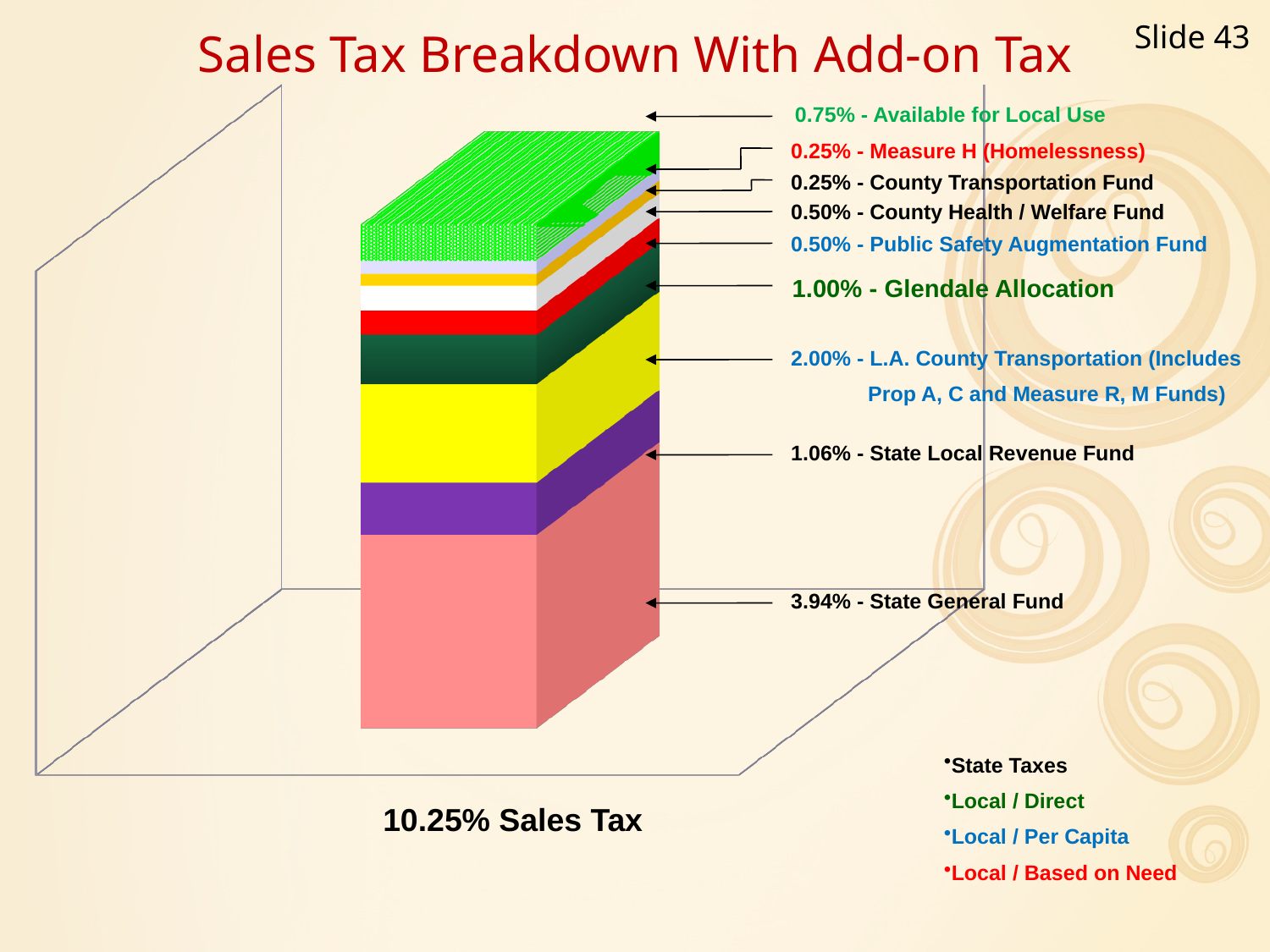
Which segment of the stacked bar has the largest share? State General Fund What percentage is Available for Local Use? 0.75% What percentage is the Glendale Allocation? 1.00% How many segments make up the stacked bar? 9 What percentage of the sales tax goes to the State General Fund? 3.94% Which is larger, the State Local Revenue Fund share or the Glendale Allocation? State Local Revenue Fund What is the difference between the State General Fund share and the L.A. County Transportation share? 1.94% What percentage is allocated to the State Local Revenue Fund? 1.06% What percentage goes to L.A. County Transportation? 2.00% What kind of chart is shown on the slide? Stacked bar chart What is the title of the chart? Sales Tax Breakdown With Add-on Tax What is the total sales tax rate shown for the stacked bar? 10.25%